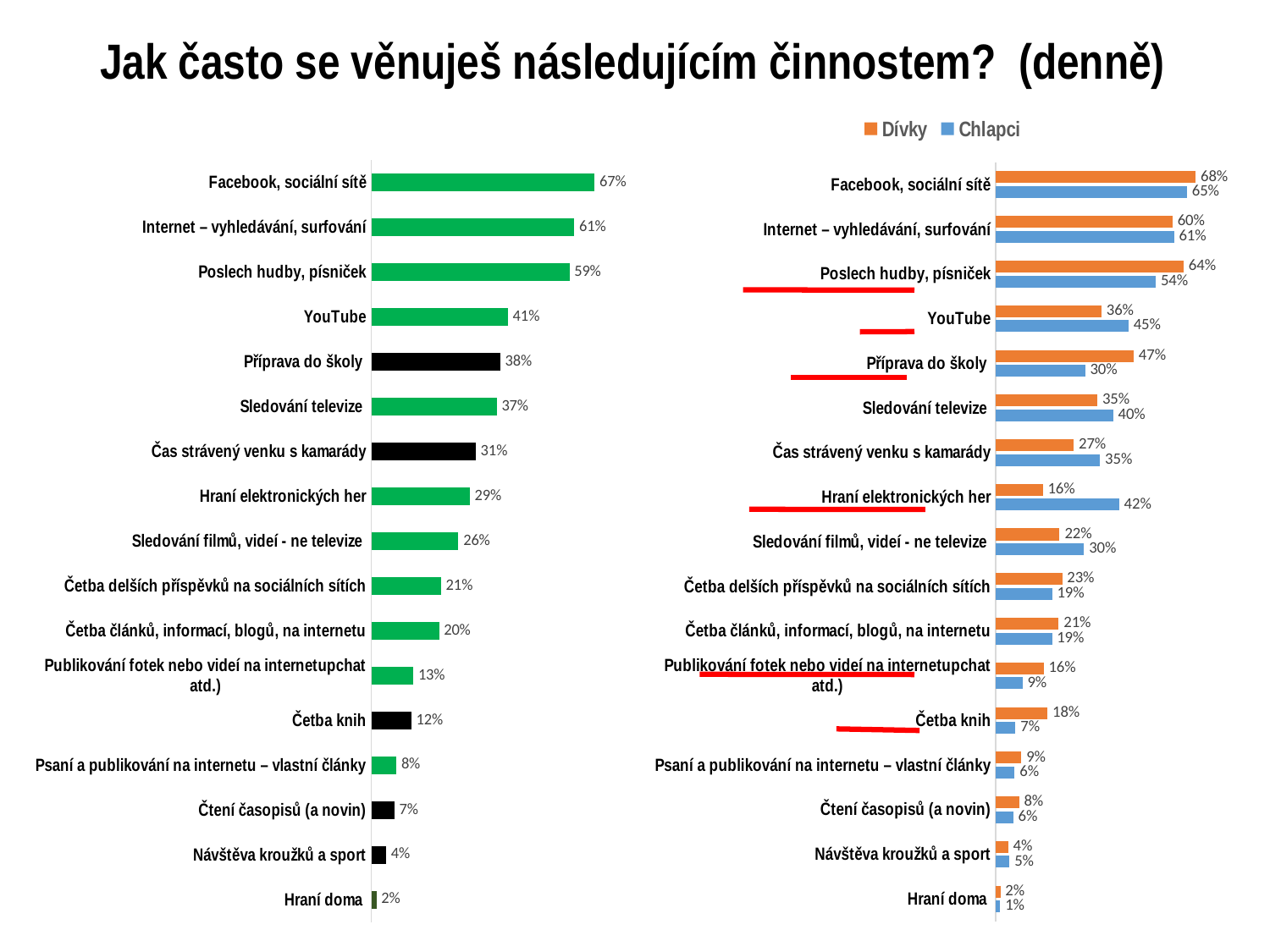
In the right chart, what is the Chlapci value for Poslech hudby, písniček? 54% In the left chart, which category has the lowest value? Hraní doma How many categories does the left chart show? 17 In the right chart, what is the difference between Chlapci and Dívky for Hraní elektronických her? 26% In the right chart, which is larger for Příprava do školy, Dívky or Chlapci? Dívky In the left chart, which category has the highest value? Facebook, sociální sítě In the left chart, what is the value for YouTube? 41% In the left chart, what is the difference between Příprava do školy and Sledování televize? 1% What kind of chart is the right chart? Bar chart In the right chart, what is the Dívky value for Hraní elektronických her? 16% In the right chart, which colour represents Chlapci? Blue How many series does the legend of the right chart list? 2